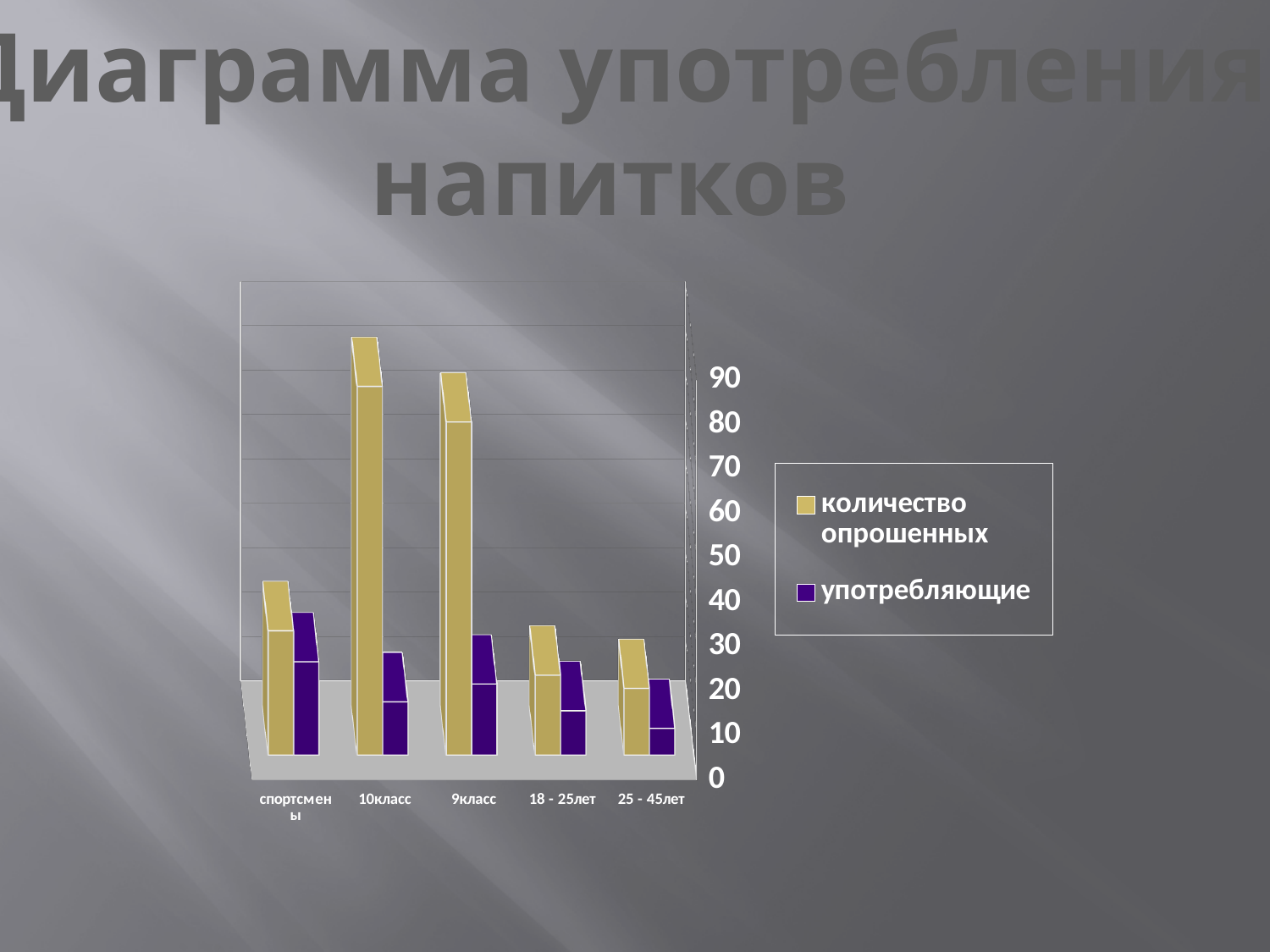
What colour are the bars for the series употребляющие? purple Is the value of количество опрошенных for спортсмены greater or less than 40? less Which is larger: количество опрошенных for 10класс or for 9класс? 10класс Which category has the highest value for употребляющие? спортсмены How many categories are shown along the x axis of the chart? 5 How many series does the chart legend list? 2 Which category has the lowest value for употребляющие? 25 - 45лет Is the value of употребляющие for 10класс greater or less than 30? less Is the value of количество опрошенных for 10класс greater or less than 80? greater Which category has the highest value for количество опрошенных? 10класс What kind of chart is shown on the slide? bar chart